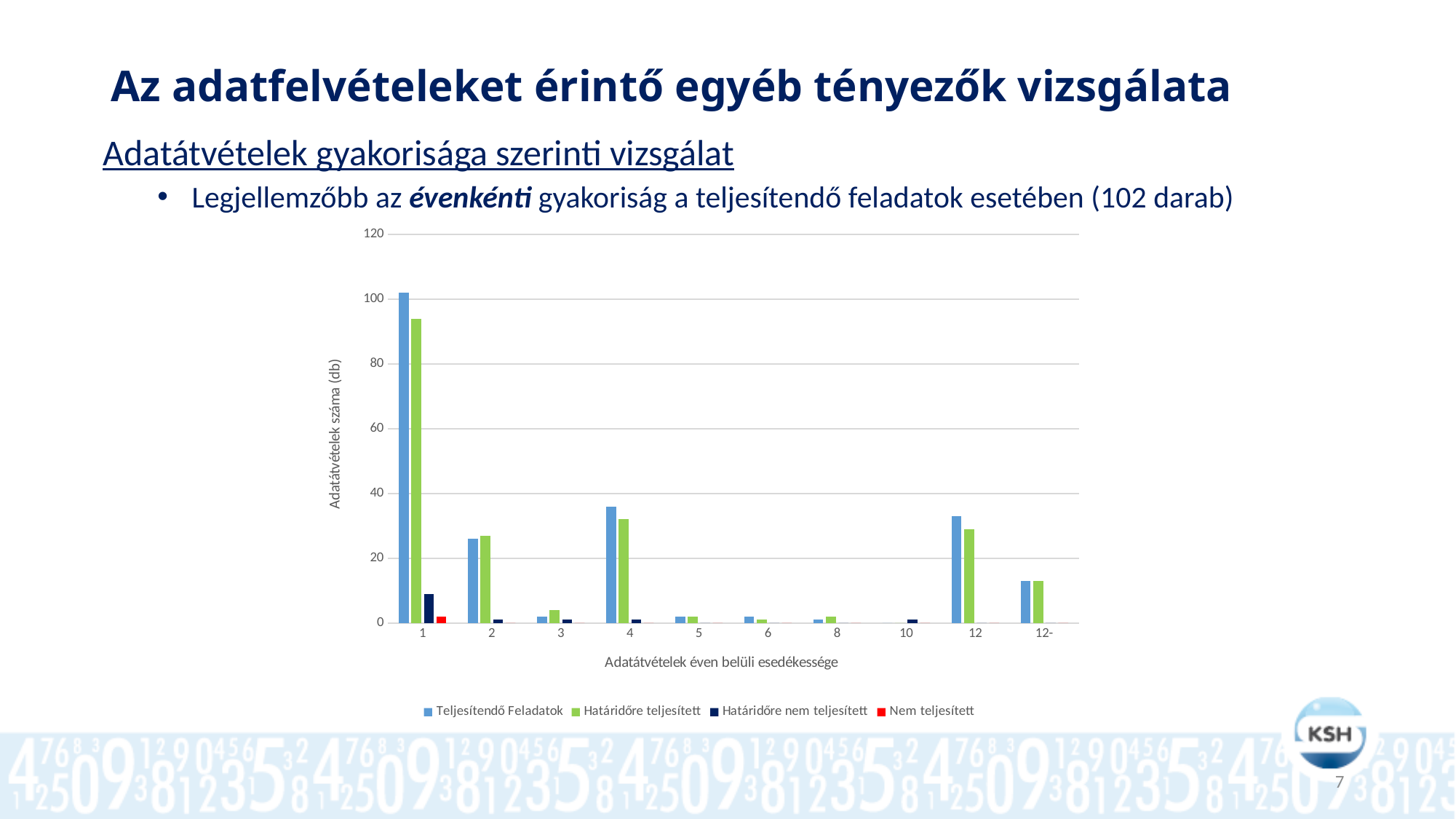
How many series does the legend list? 4 Is the value of Teljesítendő Feladatok for category 4 greater or less than 20? greater Which category has the highest value for Határidőre teljesített? 1 Is the value of Teljesítendő Feladatok for category 12 greater or less than 40? less How many categories are shown on the x axis? 10 What is the value of Teljesítendő Feladatok for category 1? 102 What is the title of the y axis of the chart? Adatátvételek száma (db) Is the value of Határidőre teljesített for category 12- greater or less than 20? less Which category has the highest value for Teljesítendő Feladatok? 1 What kind of chart is shown on the slide? bar chart Which is larger: Teljesítendő Feladatok for category 1 or for category 12? category 1